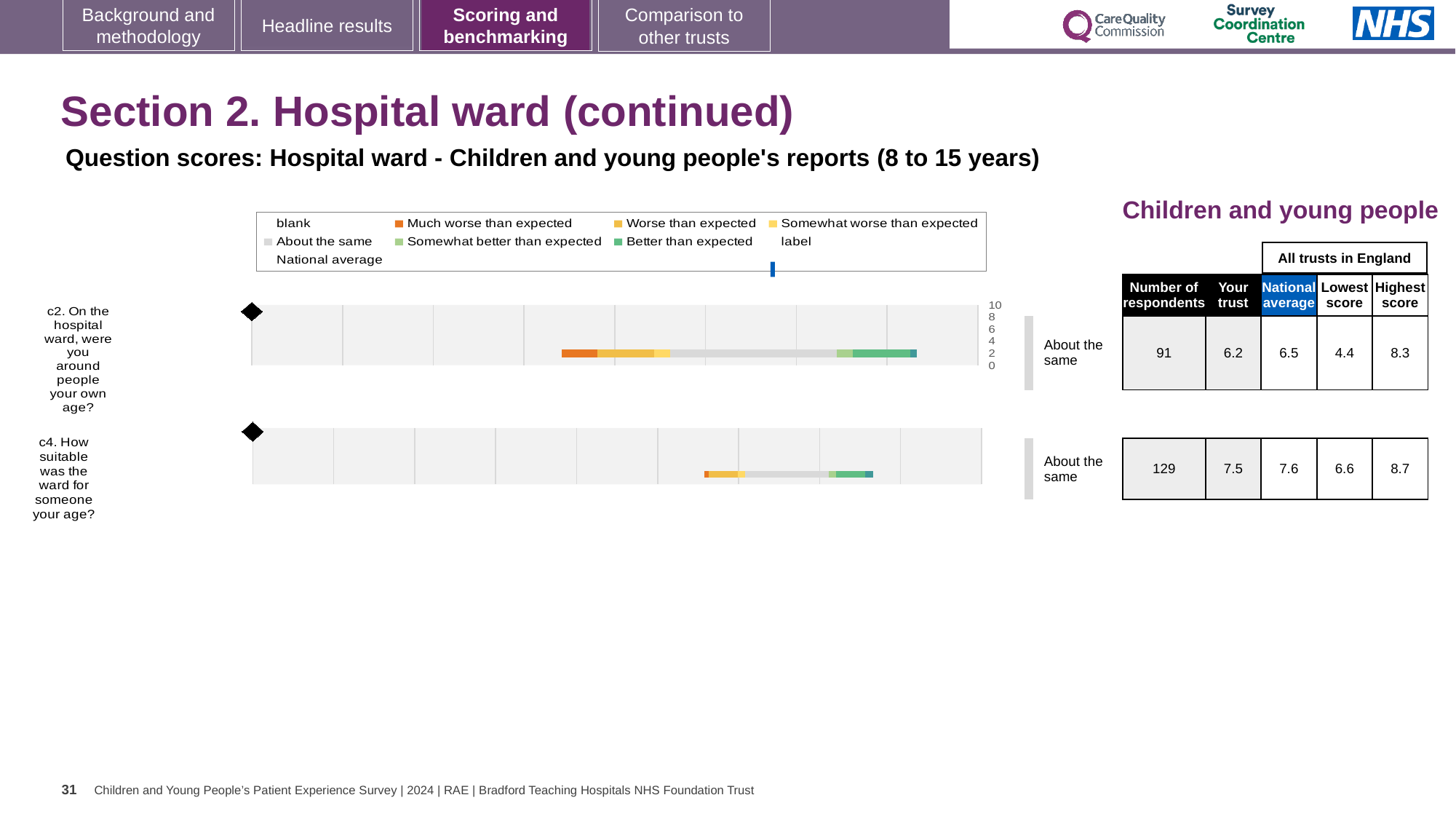
What is the lowest score across all trusts in England for question c4? 6.6 What benchmark category is shown for question c2? About the same For question c2, is the trust's score higher or lower than the national average? lower What is the difference between the national average and the trust's score for question c4? 0.1 What kind of chart is used to show the question scores on this slide? bar chart Which question has more respondents, c2 or c4? c4 Which question has the higher 'Your trust' score, c2 or c4? c4 How many questions are plotted in the chart on this slide? 2 What is the national average score for question c4 (How suitable was the ward for someone your age?)? 7.6 How many respondents answered question c2? 91 What is the difference between the highest score and the lowest score for question c2? 3.9 What is the 'Your trust' score for question c2 (On the hospital ward, were you around people your own age?)? 6.2